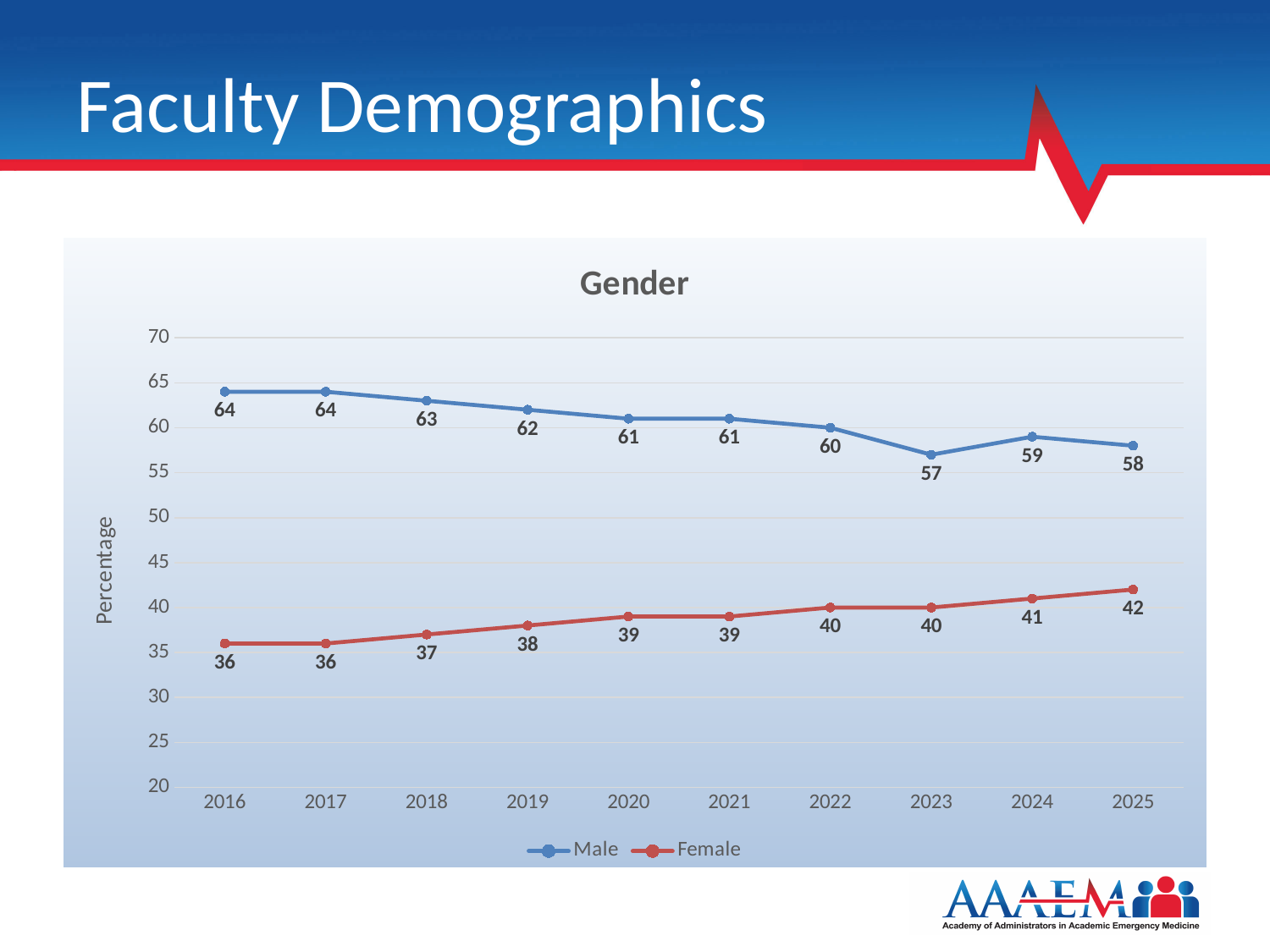
What is the Male value for 2016? 64 In which year is the Female value highest? 2025 What is the Male value for 2023? 57 What is the difference between the Male and Female values in 2025? 16 How many years are shown on the x axis? 10 Which series has the larger value in 2020, Male or Female? Male In which year is the Male value lowest? 2023 What is the Female value for 2025? 42 How many series does the legend list? 2 What is the title of the chart? Gender Does the Female series rise or fall from 2016 to 2025? Rise What kind of chart is shown? Line chart